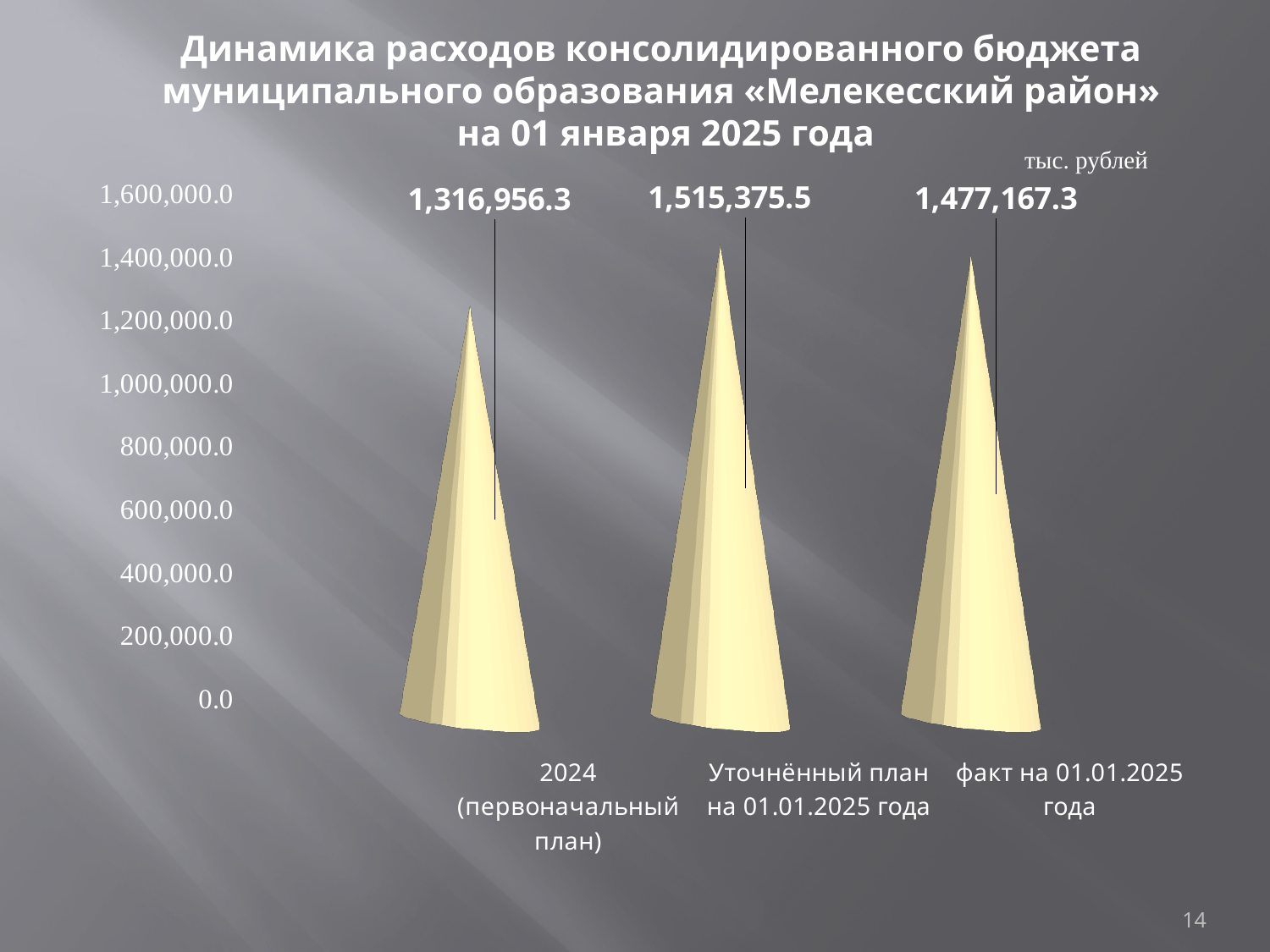
Is the value for «2024 (первоначальный план)» greater or less than 1,400,000.0? less What is the value for «2024 (первоначальный план)»? 1,316,956.3 What is the difference between «Уточнённый план на 01.01.2025 года» and «2024 (первоначальный план)»? 198,419.2 How many categories are shown on the chart? 3 Which category has the lowest value? 2024 (первоначальный план) What is the value for «факт на 01.01.2025 года»? 1,477,167.3 What kind of chart is shown on the slide? bar chart In what units are the values on the chart expressed? тыс. рублей Which category has the highest value? Уточнённый план на 01.01.2025 года What is the difference between «Уточнённый план на 01.01.2025 года» and «факт на 01.01.2025 года»? 38,208.2 Which is larger: «факт на 01.01.2025 года» or «2024 (первоначальный план)»? факт на 01.01.2025 года What is the value for «Уточнённый план на 01.01.2025 года»? 1,515,375.5